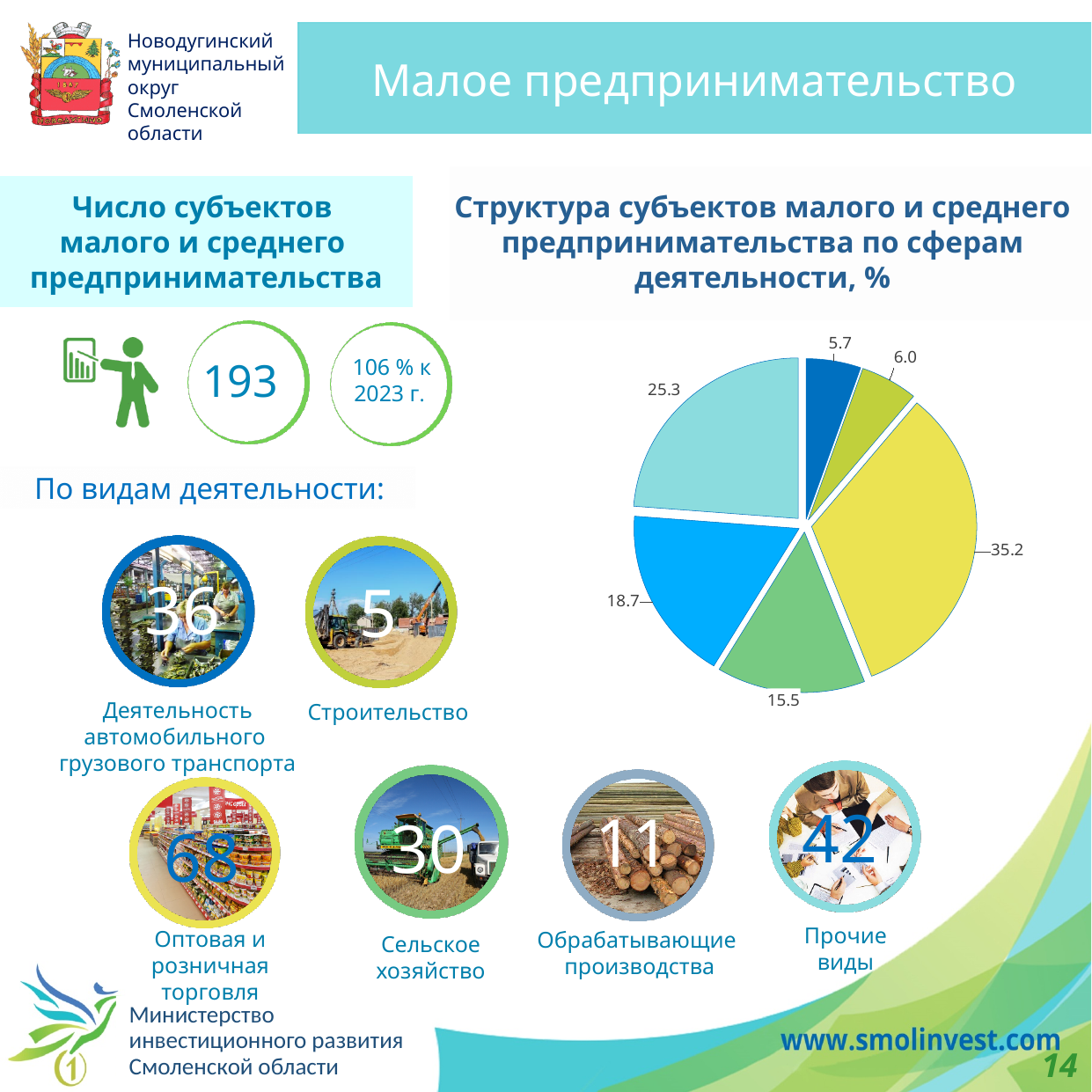
What is the value of the largest slice in the pie chart? 35.2 What kind of chart is shown under the title "Структура субъектов малого и среднего предпринимательства по сферам деятельности, %"? pie chart What is the value of the second-largest slice in the pie chart? 25.3 In the pie chart, what is the difference between the largest slice (35.2) and the slice labelled 25.3? 9.9 In the pie chart, which is larger: the slice labelled 6.0 or the slice labelled 5.7? 6.0 In the pie chart, which is larger: the slice labelled 25.3 or the slice labelled 18.7? 25.3 What is the title of the pie chart on the slide? Структура субъектов малого и среднего предпринимательства по сферам деятельности, % What is the value of the smallest slice in the pie chart? 5.7 In the pie chart, what is the difference between the slices labelled 18.7 and 15.5? 3.2 In the pie chart, what is the difference between the slices labelled 6.0 and 5.7? 0.3 How many slices does the pie chart have? 6 What colour is the largest slice (35.2) of the pie chart? yellow